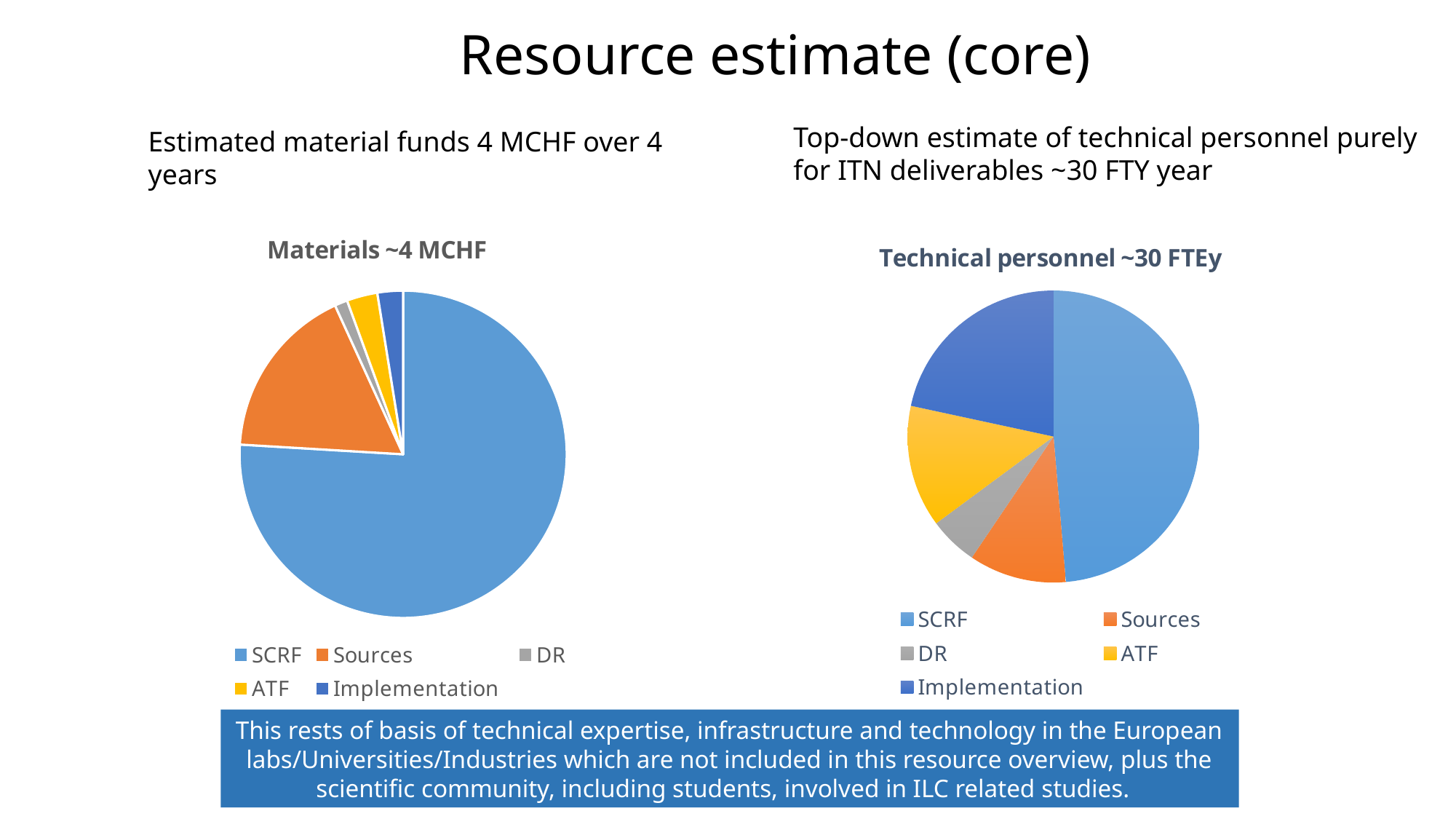
In the "Materials ~4 MCHF" chart, which category has the smallest slice? DR In the "Technical personnel ~30 FTEy" chart, which category has the largest slice? SCRF What kind of chart is the "Materials ~4 MCHF" chart? pie chart In the "Materials ~4 MCHF" chart, which category has the largest slice? SCRF In the "Technical personnel ~30 FTEy" chart, which slice is larger, SCRF or Implementation? SCRF In the "Technical personnel ~30 FTEy" chart, which slice is larger, Implementation or Sources? Implementation In the "Technical personnel ~30 FTEy" chart, which category has the smallest slice? DR What is the title of the pie chart on the right of the slide? Technical personnel ~30 FTEy How many slices does the "Technical personnel ~30 FTEy" pie chart have? 5 In the "Materials ~4 MCHF" chart, which slice is larger, Sources or ATF? Sources How many categories does the legend of the "Materials ~4 MCHF" chart list? 5 What kind of chart is the "Technical personnel ~30 FTEy" chart? pie chart